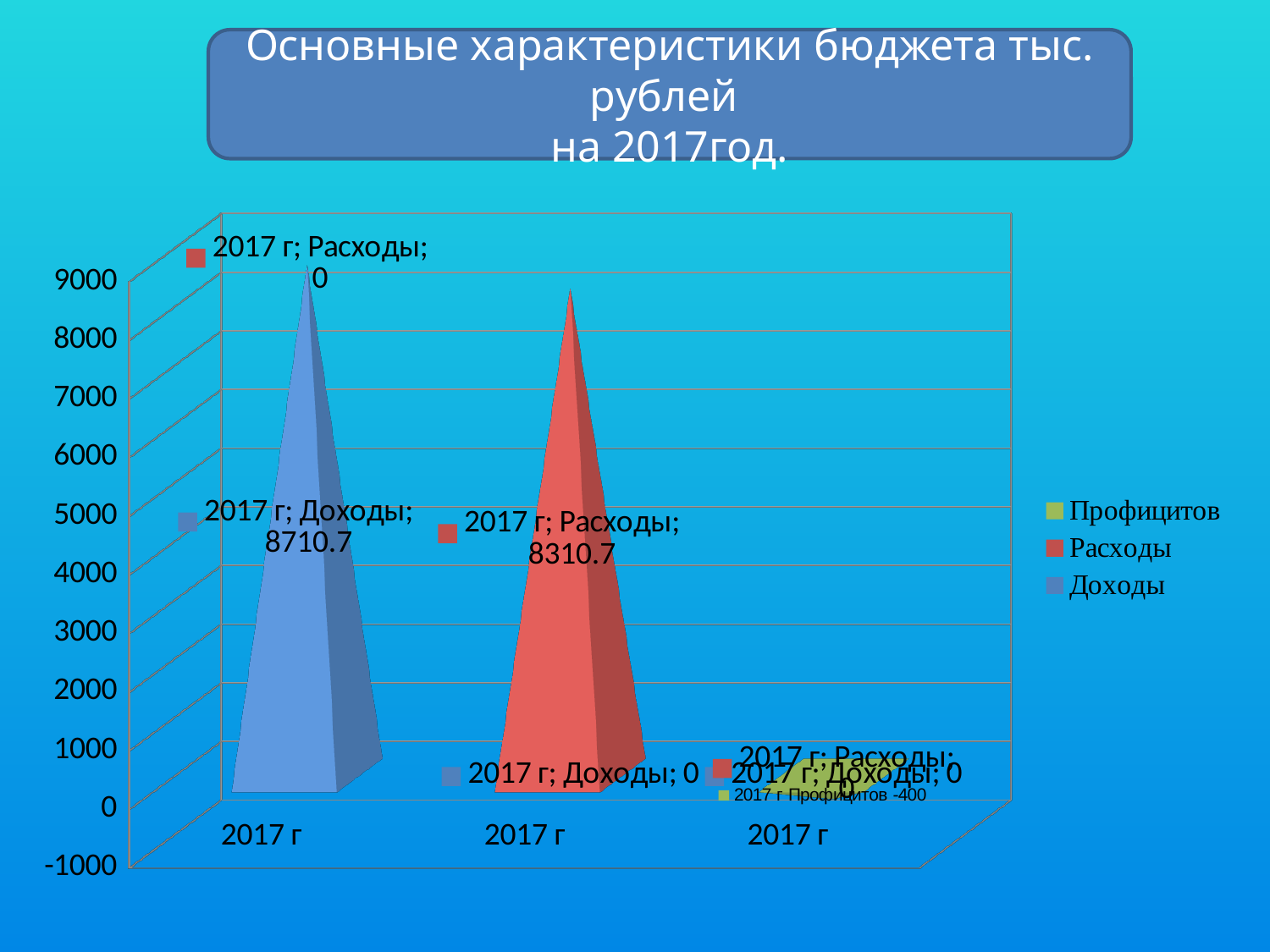
What is the value of Доходы shown on the chart? 8710.7 Which series has the highest value on the chart? Доходы Is the value for Профицитов greater or less than 0? less Which series has the lowest value on the chart? Профицитов What is the title of the chart on the slide? Основные характеристики бюджета тыс. рублей на 2017год. What kind of chart is shown on the slide? bar chart What is the difference between Доходы (8710.7) and Расходы (8310.7)? 400 What is the value of Профицитов shown on the chart? -400 How many series does the legend list? 3 Is the value for Расходы greater or less than 8000? greater Which is larger, Доходы or Расходы? Доходы What is the value of Расходы shown on the chart? 8310.7